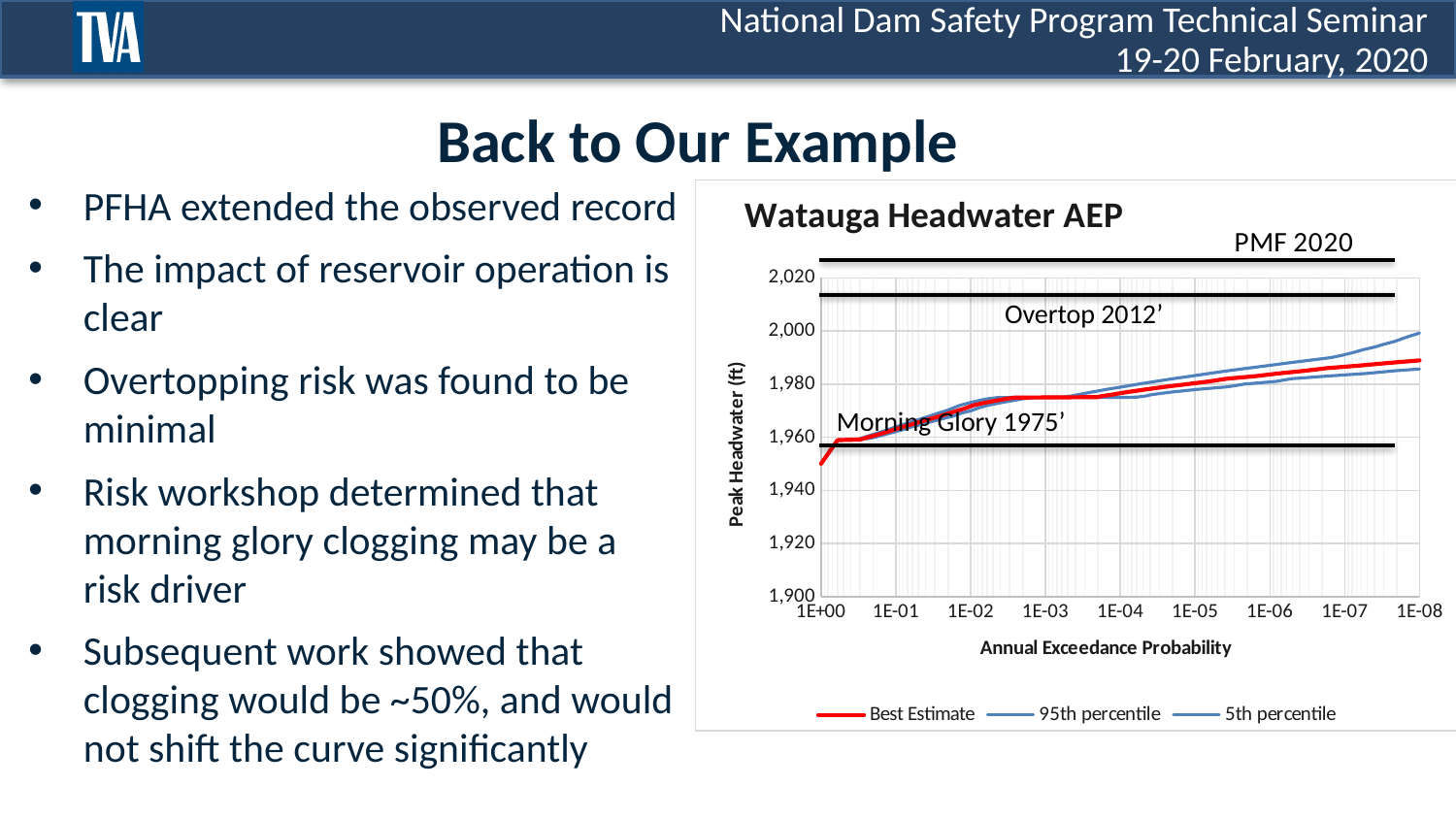
What is the label of the horizontal axis of the chart? Annual Exceedance Probability Is the Best Estimate value at 1E+00 greater or less than 1,960? less What is the highest value shown on the vertical axis of the chart? 2,020 How many tick labels are shown on the horizontal axis of the chart? 9 How many series does the chart legend list? 3 What is the label of the vertical axis of the chart? Peak Headwater (ft) Do the plotted curves rise or fall as you move along the x axis from 1E+00 to 1E-08? rise Which series is drawn in red in the chart? Best Estimate What is the title of the chart on the slide? Watauga Headwater AEP What kind of chart is shown on the slide? line chart Is the Best Estimate value at 1E-08 greater or less than 1,980? greater